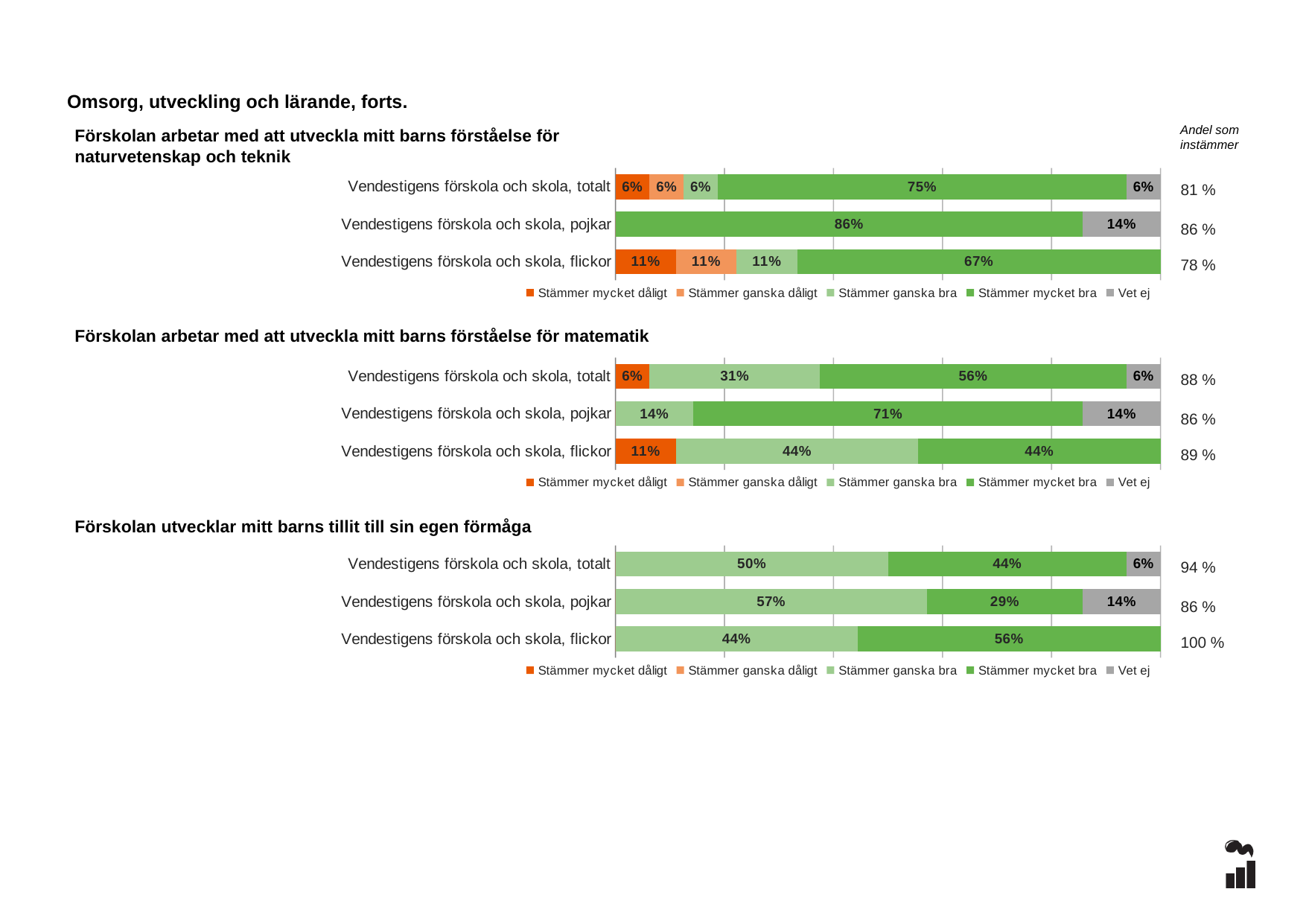
In the chart 'Förskolan arbetar med att utveckla mitt barns förståelse för naturvetenskap och teknik', what is the 'Stämmer mycket bra' value for 'Vendestigens förskola och skola, flickor'? 67% In the chart 'Förskolan utvecklar mitt barns tillit till sin egen förmåga', which is larger for 'Vendestigens förskola och skola, flickor': 'Stämmer ganska bra' or 'Stämmer mycket bra'? Stämmer mycket bra In the chart 'Förskolan arbetar med att utveckla mitt barns förståelse för naturvetenskap och teknik', which category has the highest 'Stämmer mycket bra' value? Vendestigens förskola och skola, pojkar In the chart 'Förskolan utvecklar mitt barns tillit till sin egen förmåga', what is the 'Stämmer ganska bra' value for 'Vendestigens förskola och skola, pojkar'? 57% What kind of chart is 'Förskolan arbetar med att utveckla mitt barns förståelse för naturvetenskap och teknik'? Stacked bar chart How many series does the legend of the chart 'Förskolan arbetar med att utveckla mitt barns förståelse för matematik' list? 5 In the chart 'Förskolan utvecklar mitt barns tillit till sin egen förmåga', what is the 'Andel som instämmer' value for 'Vendestigens förskola och skola, flickor'? 100 % In the chart 'Förskolan arbetar med att utveckla mitt barns förståelse för naturvetenskap och teknik', what is the 'Stämmer mycket bra' value for 'Vendestigens förskola och skola, pojkar'? 86% In the chart 'Förskolan arbetar med att utveckla mitt barns förståelse för matematik', what is the 'Stämmer ganska bra' value for 'Vendestigens förskola och skola, totalt'? 31% How many categories are shown in the chart 'Förskolan utvecklar mitt barns tillit till sin egen förmåga'? 3 In the chart 'Förskolan arbetar med att utveckla mitt barns förståelse för matematik', what is the 'Vet ej' value for 'Vendestigens förskola och skola, pojkar'? 14% In the chart 'Förskolan arbetar med att utveckla mitt barns förståelse för matematik', what is the difference between the 'Stämmer mycket bra' values for pojkar and totalt? 15%